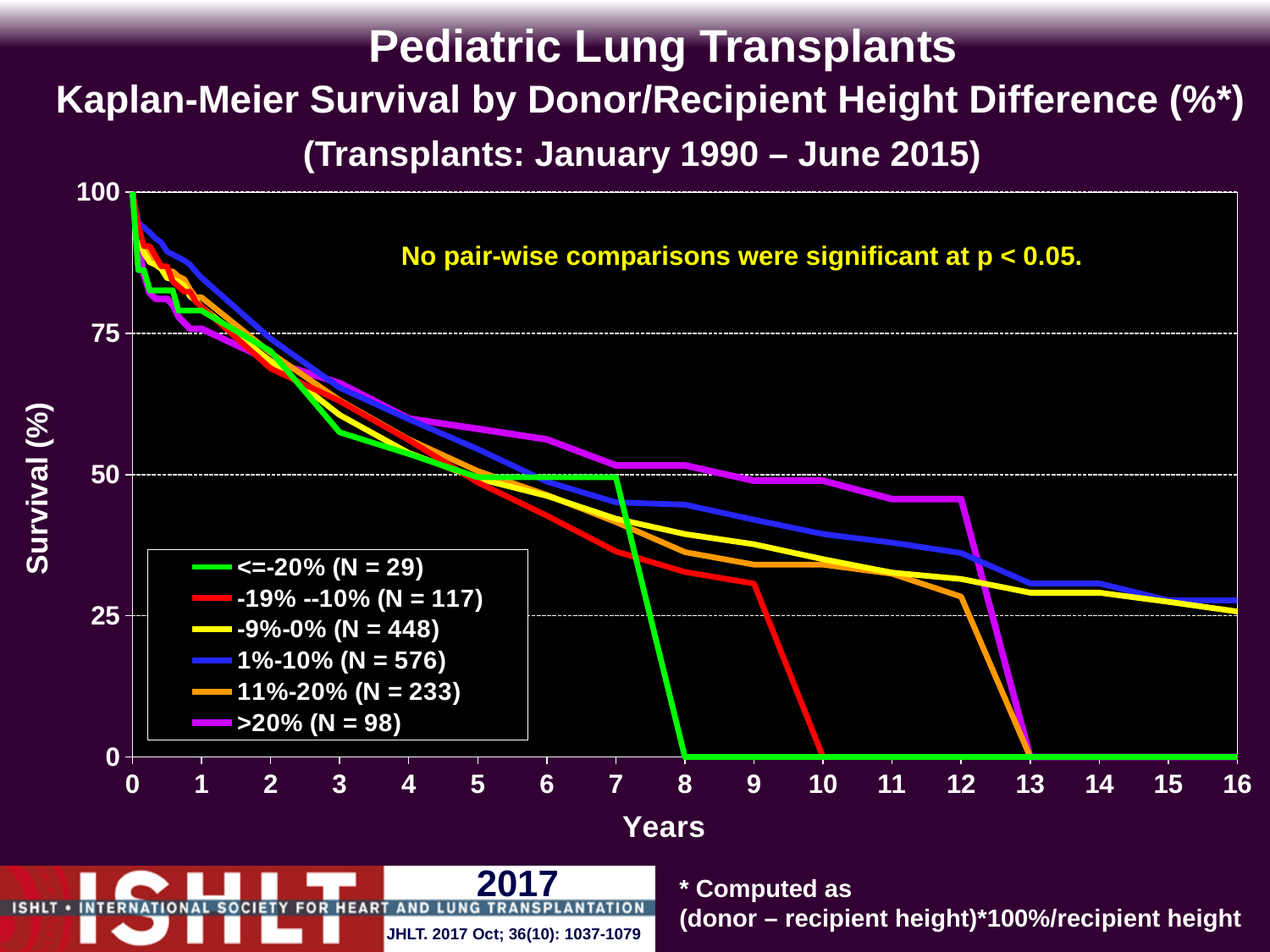
What is the label of the x axis? Years Which height difference group has the smallest N in the legend? <=-20% (N = 29) What is the N for the 1%-10% height difference group shown in the legend? 576 Is the survival value for the >20% group at 12 years greater or less than 25? greater How many series does the legend list? 6 Is the survival value for the 1%-10% group at 10 years greater or less than 50? less What is the N for the -9%-0% height difference group shown in the legend? 448 Do the survival curves rise or fall as years increase? fall Which height difference group has the largest N in the legend? 1%-10% (N = 576) Is the survival value for the <=-20% group at 3 years greater or less than 50? greater What kind of chart is shown on the slide? line chart At 12 years, which group has the higher survival: >20% or 1%-10%? >20%